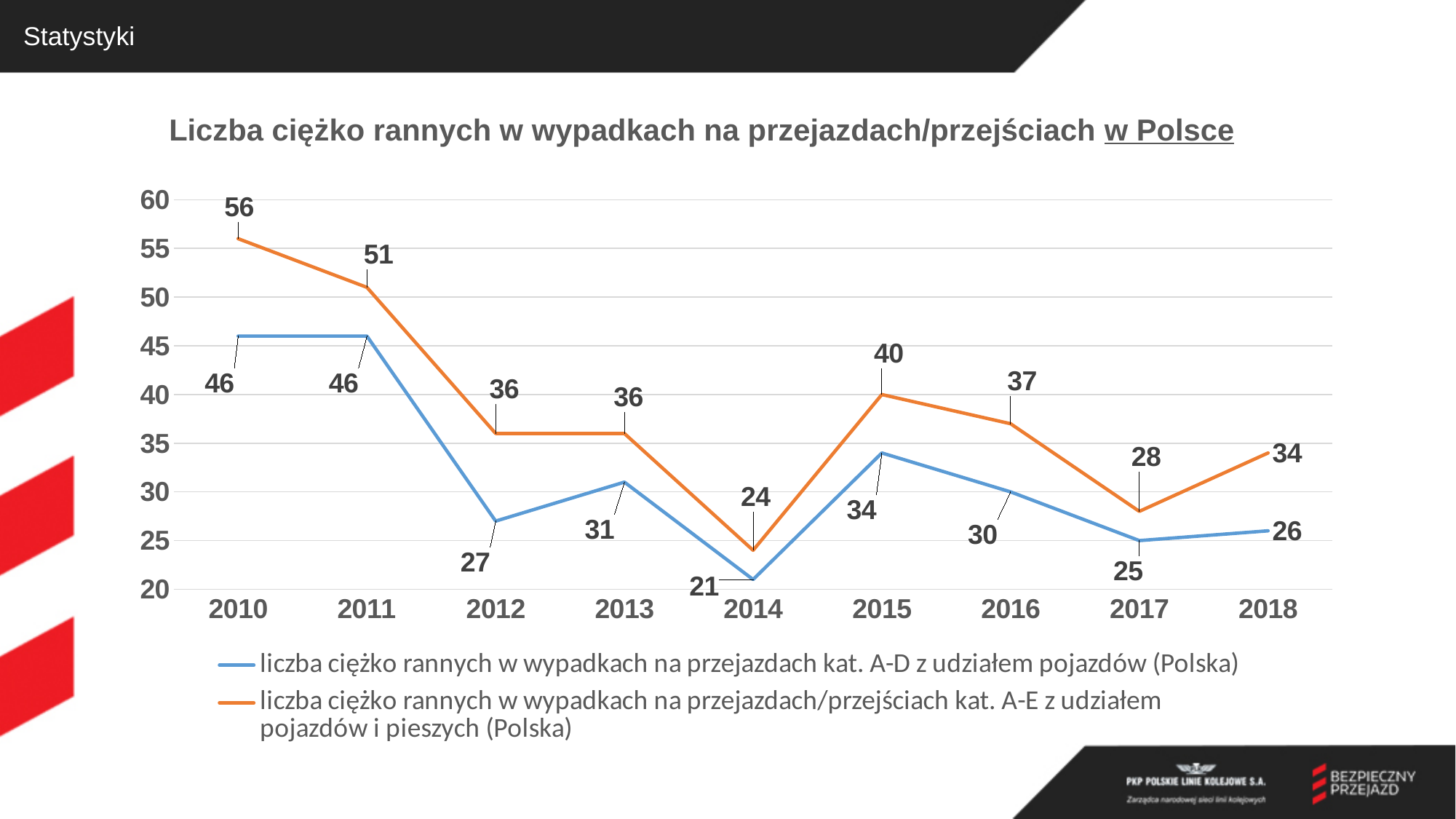
What is the value for 2010 in the series 'kat. A-E z udziałem pojazdów i pieszych (Polska)'? 56 What is the value for 2014 in the series 'kat. A-D z udziałem pojazdów (Polska)'? 21 How many series does the legend list? 2 How many years are shown on the x axis? 9 What colour is the line for the series 'kat. A-E z udziałem pojazdów i pieszych (Polska)'? orange Does the series 'kat. A-D z udziałem pojazdów (Polska)' rise or fall from 2011 to 2012? fall What is the value for 2017 in the series 'kat. A-E z udziałem pojazdów i pieszych (Polska)'? 28 What is the difference between the two series in 2015? 6 In which year is the series 'kat. A-E z udziałem pojazdów i pieszych (Polska)' at its highest? 2010 What type of chart is shown on the slide? line chart In which year is the series 'kat. A-D z udziałem pojazdów (Polska)' at its lowest? 2014 Which series has the larger value in 2018? kat. A-E z udziałem pojazdów i pieszych (Polska)